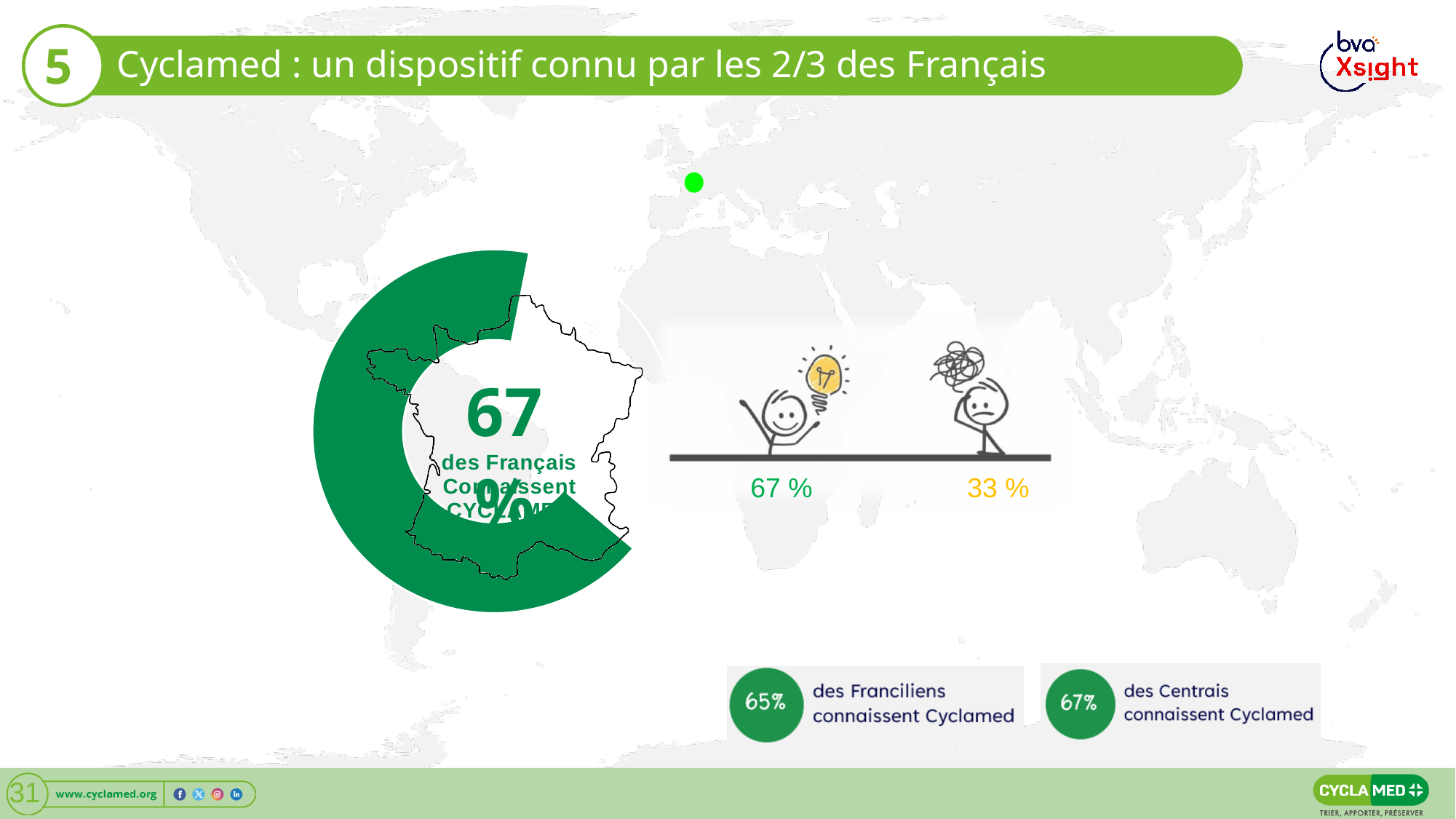
What percentage of Centrais know Cyclamed, according to the callout at the bottom of the slide? 67% In the figure with the two stick characters, what percentage is shown under the confused character? 33 % What is the difference in percentage points between the share of Centrais and the share of Franciliens who know Cyclamed? 2 percentage points Is the share of French people who know Cyclamed shown in the donut chart greater or less than 50%? greater Which group has the higher share knowing Cyclamed: Franciliens or Centrais? Centrais What percentage of French people know Cyclamed, according to the donut chart? 67 % In the figure with the two stick characters, what percentage is shown under the happy character with the light bulb? 67 % What is the difference in percentage points between the 67 % and 33 % values shown in the stick-character figure? 34 percentage points Which is larger in the stick-character figure: the share who know Cyclamed or the share who do not? The share who know Cyclamed (67 %) What percentage of Franciliens know Cyclamed, according to the callout at the bottom of the slide? 65% What kind of chart is used to show the share of French people who know Cyclamed? Donut (pie) chart What colour is the filled portion of the donut chart? Green